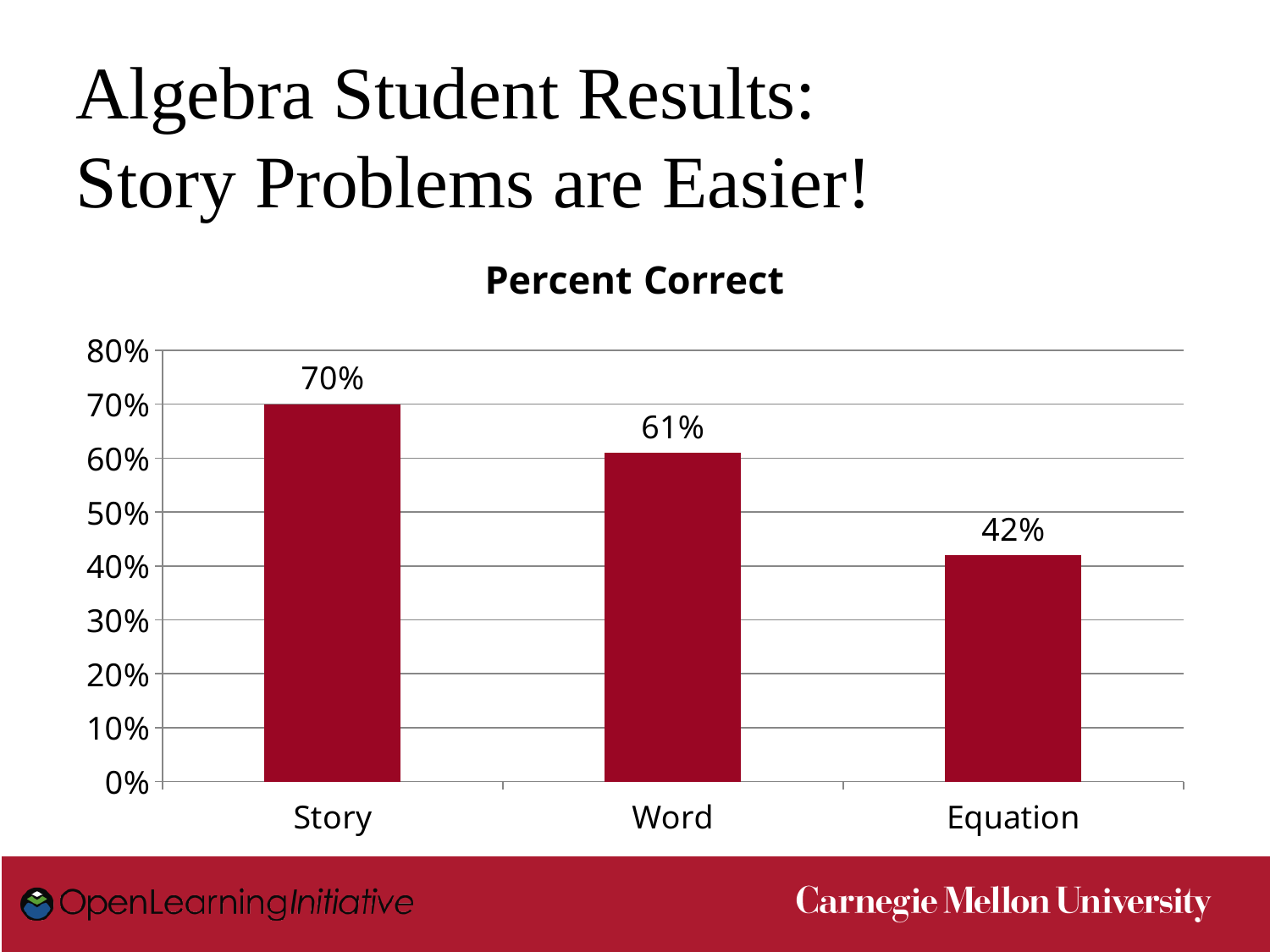
What is the difference in percent correct between Story and Word? 9% Which has a higher percent correct, Word or Equation? Word What is the percent correct for Story problems? 70% Is the value for Equation greater or less than 50%? less What is the title of the chart? Percent Correct Which category has the highest percent correct? Story What is the percent correct for Equation problems? 42% What is the difference in percent correct between Story and Equation? 28% What is the percent correct for Word problems? 61% How many categories are shown on the chart? 3 What kind of chart is shown on the slide? Bar chart Which category has the lowest percent correct? Equation